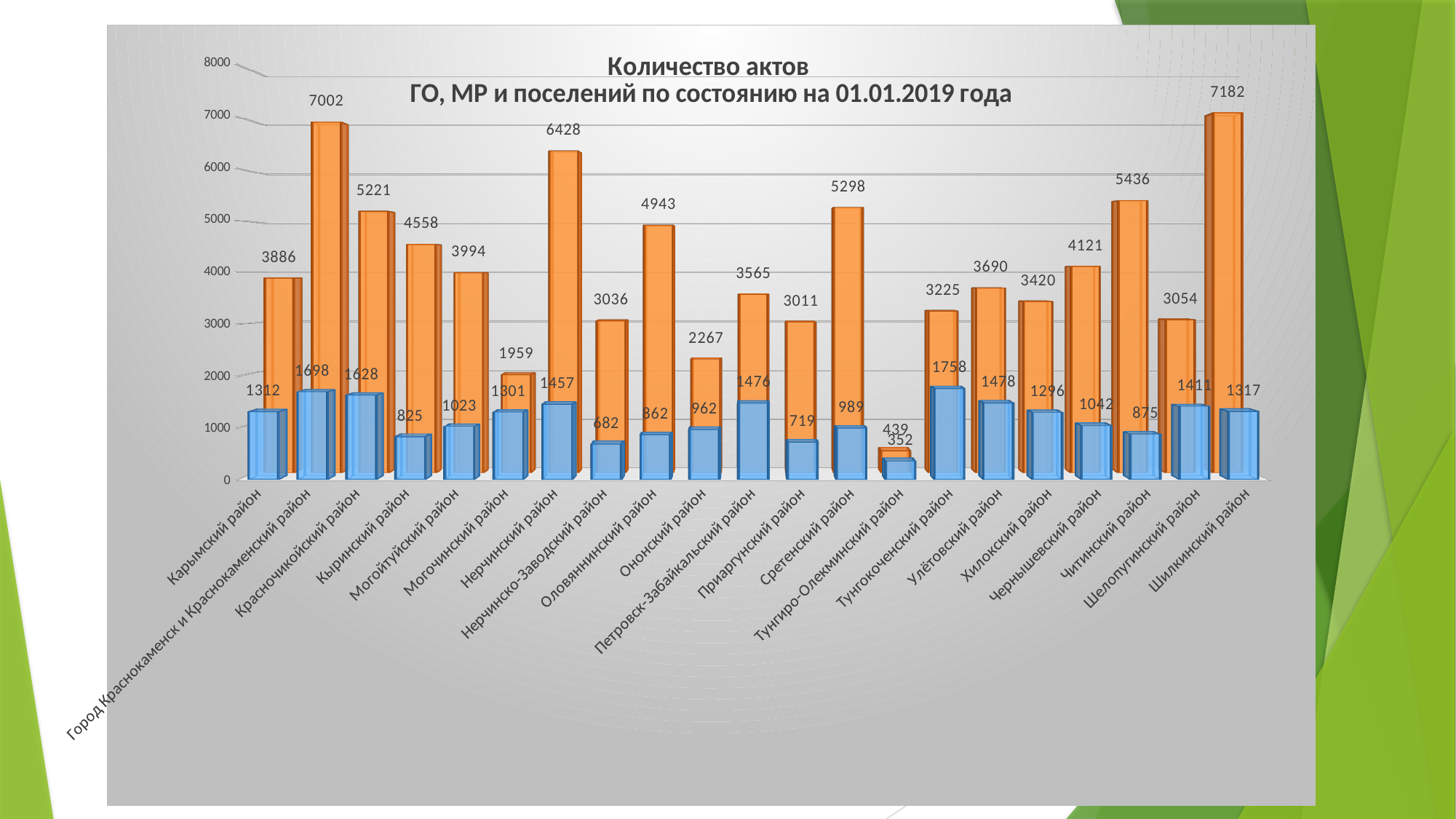
Which district has the lowest orange bar? Тунгиро-Олекминский район How many districts (categories) are shown on the x axis of the chart? 21 Which district has the highest orange bar? Шилкинский район What is the value of the orange bar for Шилкинский район? 7182 What is the value of the blue bar for Кыринский район? 825 What kind of chart is shown on the slide? Bar chart What is the value of the orange bar for Сретенский район? 5298 What is the difference between the orange bars for Город Краснокаменск и Краснокаменский район and Карымский район? 3116 What is the title of the chart? Количество актов ГО, МР и поселений по состоянию на 01.01.2019 года Which district has the highest blue bar? Тунгокоченский район Which is larger: the orange bar for Читинский район or the orange bar for Красночикойский район? Читинский район What is the difference between the orange bar and the blue bar for Нерчинский район? 4971